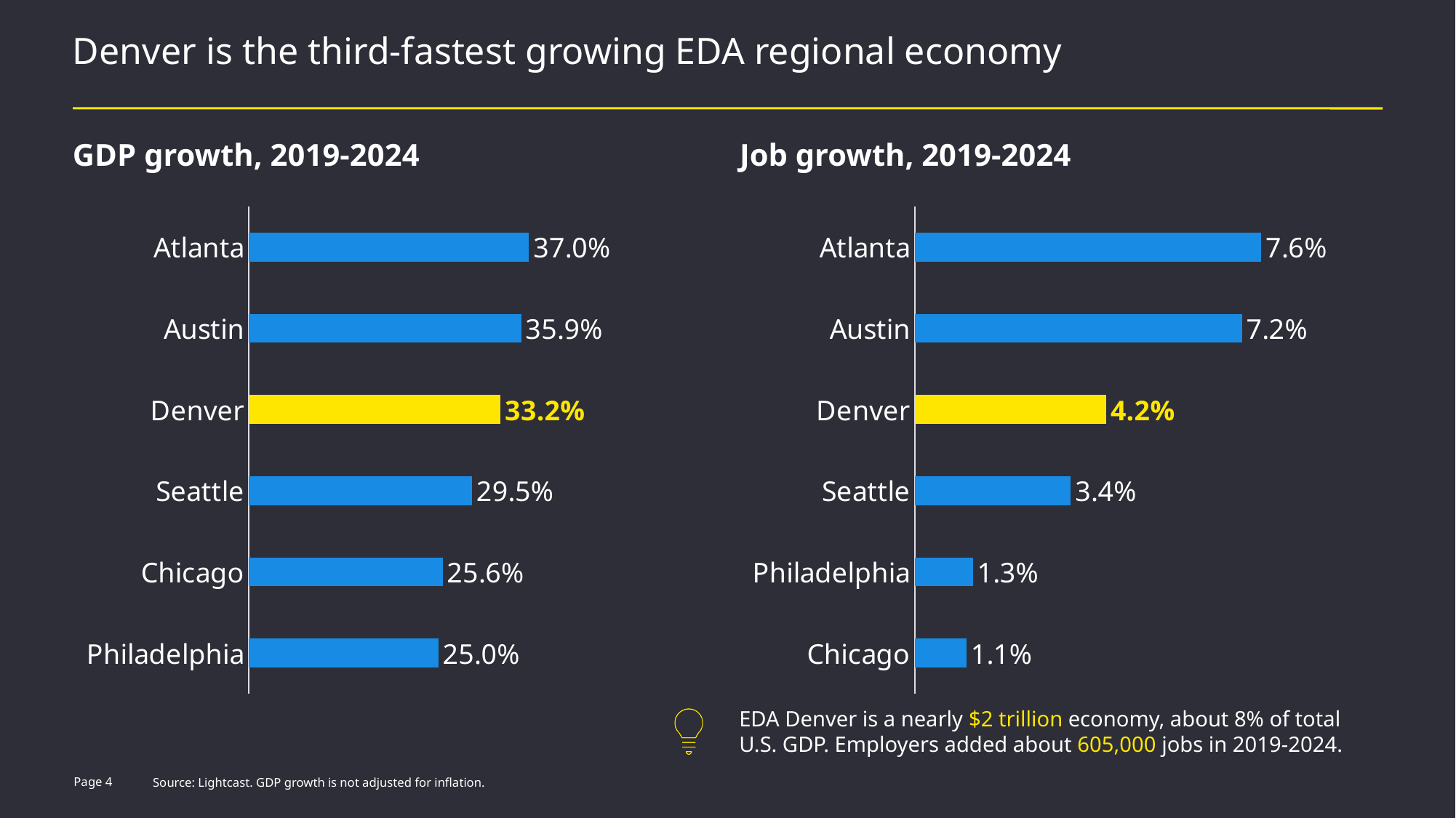
In the 'GDP growth, 2019-2024' chart, which city has the highest value? Atlanta In the 'GDP growth, 2019-2024' chart, which city has the lowest value? Philadelphia In the 'Job growth, 2019-2024' chart, what is the difference between Atlanta and Austin? 0.4% What kind of chart is the 'GDP growth, 2019-2024' chart? Bar chart In the 'Job growth, 2019-2024' chart, what is the value for Seattle? 3.4% In the 'GDP growth, 2019-2024' chart, which is larger, Seattle or Chicago? Seattle In the 'Job growth, 2019-2024' chart, which is larger, Philadelphia or Chicago? Philadelphia In the 'GDP growth, 2019-2024' chart, what is the value for Denver? 33.2% In the 'Job growth, 2019-2024' chart, which city has the lowest value? Chicago In the 'GDP growth, 2019-2024' chart, what is the difference between Atlanta and Denver? 3.8% In the 'Job growth, 2019-2024' chart, which city's bar is highlighted in yellow? Denver How many cities are shown in the 'Job growth, 2019-2024' chart? 6